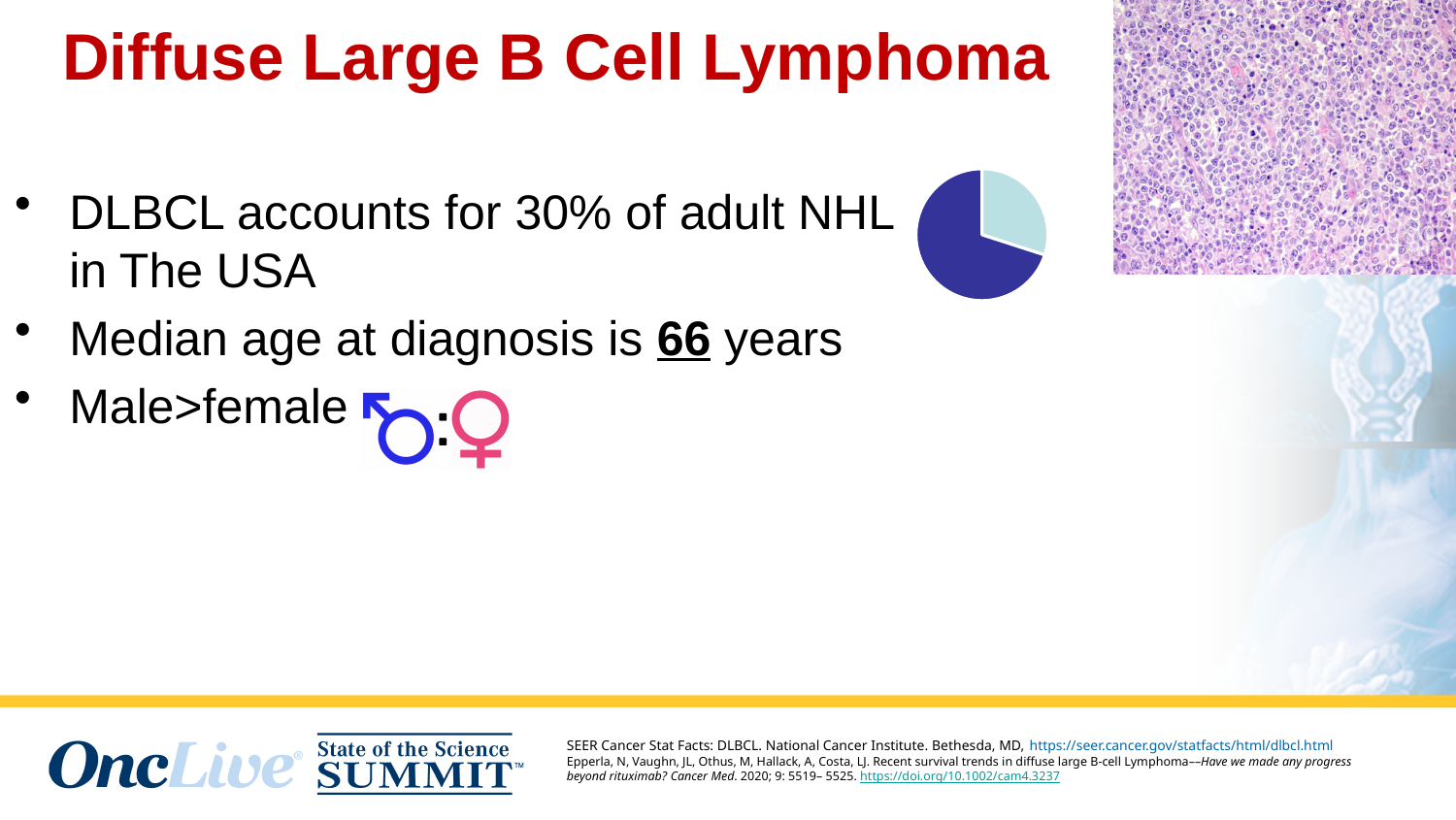
Does the pie chart display a legend? No Is the light blue slice of the pie chart greater or less than half of the pie? less What kind of chart is shown on the slide? pie chart Which slice of the pie chart is the smallest? the light blue slice What two colours are used for the slices of the pie chart? dark blue and light blue According to the slide text, what share of adult NHL in the USA does DLBCL (the smaller pie slice) account for? 30% Is the dark blue slice of the pie chart greater or less than half of the pie? greater How many slices does the pie chart have? 2 Which slice of the pie chart is larger, the dark blue one or the light blue one? dark blue